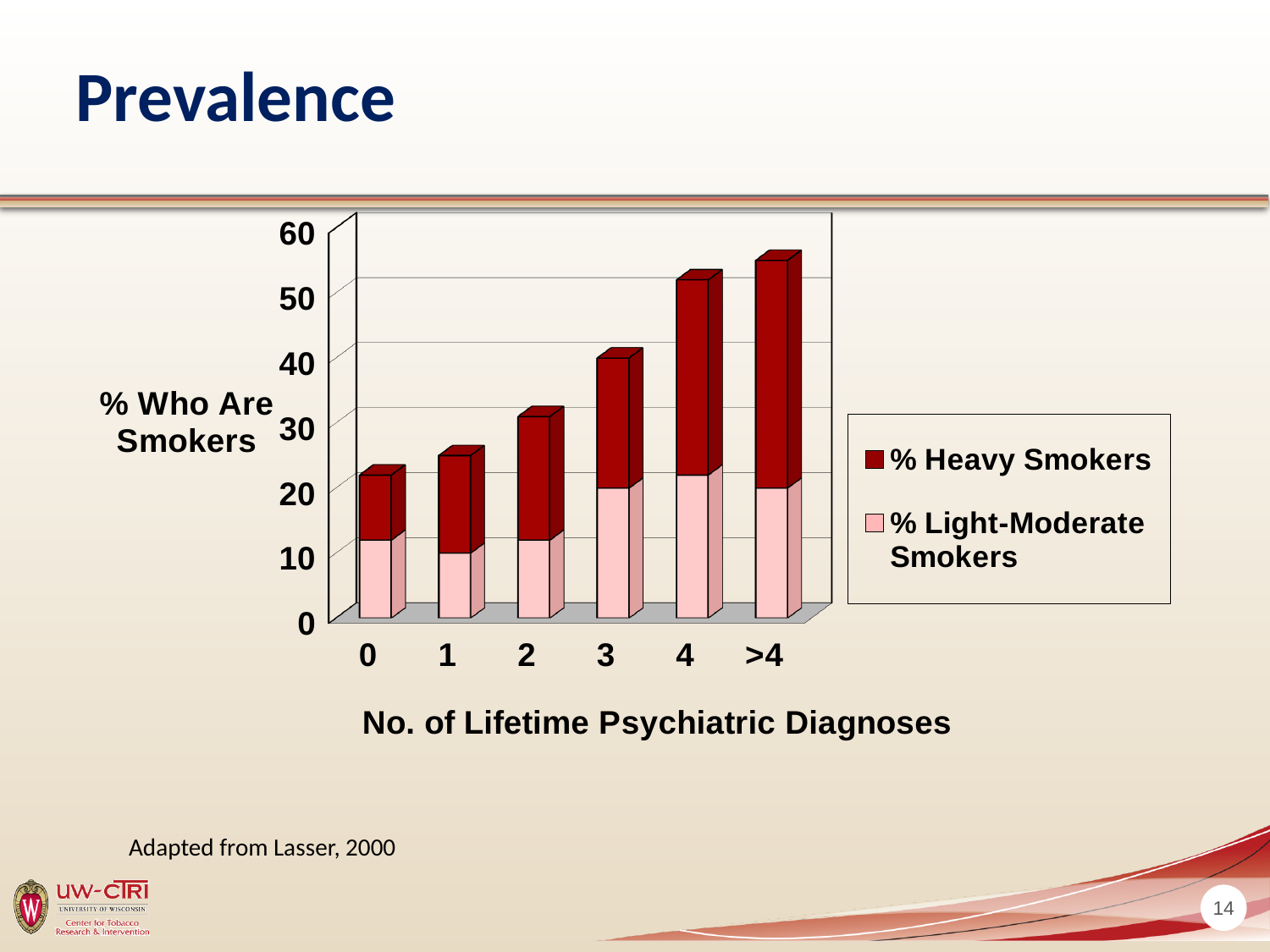
Is the total percentage of smokers for 3 diagnoses greater or less than 30? greater What is the label of the x axis? No. of Lifetime Psychiatric Diagnoses Which has a larger total percentage of smokers: 4 diagnoses or 2 diagnoses? 4 diagnoses What kind of chart is shown on the slide? Stacked bar chart Is the total percentage of smokers for 4 diagnoses greater or less than 40? greater How many series does the legend list? 2 Which number of lifetime psychiatric diagnoses has the lowest total percentage of smokers? 0 Which number of lifetime psychiatric diagnoses has the highest total percentage of smokers? >4 Does the total percentage of smokers rise or fall as the number of lifetime psychiatric diagnoses increases? Rises Is the total percentage of smokers for >4 diagnoses greater or less than 50? greater How many categories are shown on the x axis? 6